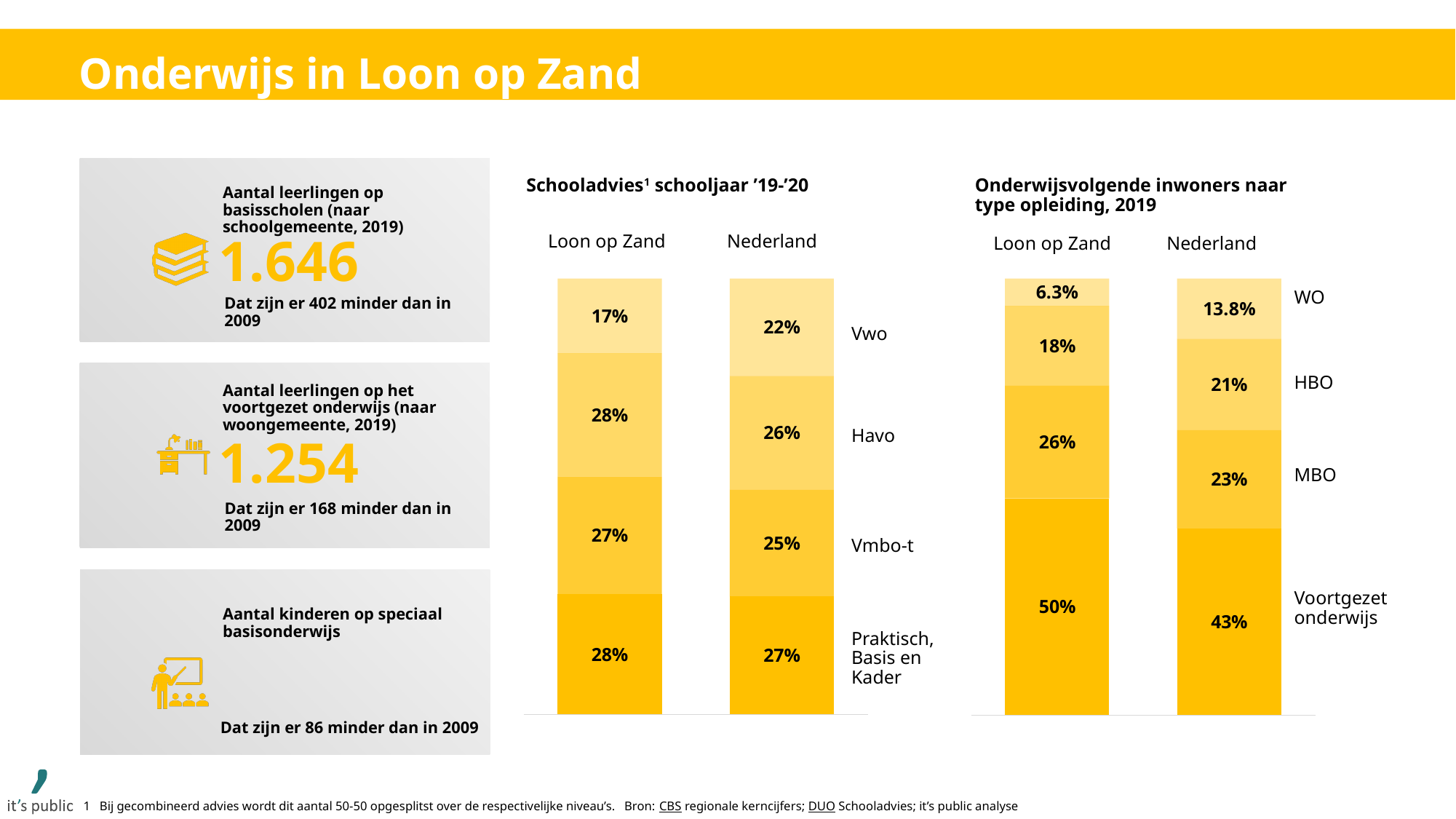
In the 'Onderwijsvolgende inwoners naar type opleiding, 2019' chart, which has a larger HBO share, Loon op Zand or Nederland? Nederland In the 'Schooladvies schooljaar '19-'20' chart, which segment is the largest in the Loon op Zand bar? Havo and Praktisch, Basis en Kader (both 28%) In the 'Onderwijsvolgende inwoners naar type opleiding, 2019' chart, which type of education has the largest share for Loon op Zand? Voortgezet onderwijs In the 'Schooladvies schooljaar '19-'20' chart, what is the Vwo share for Loon op Zand? 17% In the 'Schooladvies schooljaar '19-'20' chart, what is the Havo share for Nederland? 26% What kind of chart is the 'Schooladvies schooljaar '19-'20' chart? Stacked bar chart In the 'Onderwijsvolgende inwoners naar type opleiding, 2019' chart, what is the MBO share for Nederland? 23% In the 'Schooladvies schooljaar '19-'20' chart, which has a larger Vmbo-t share, Loon op Zand or Nederland? Loon op Zand In the 'Onderwijsvolgende inwoners naar type opleiding, 2019' chart, what is the WO share for Loon op Zand? 6.3% In the 'Schooladvies schooljaar '19-'20' chart, what is the difference between the Vwo share for Nederland and for Loon op Zand? 5 percentage points In the 'Schooladvies schooljaar '19-'20' chart, which segment is the smallest in the Nederland bar? Vwo In the 'Onderwijsvolgende inwoners naar type opleiding, 2019' chart, what is the difference between the Voortgezet onderwijs share for Loon op Zand and for Nederland? 7 percentage points